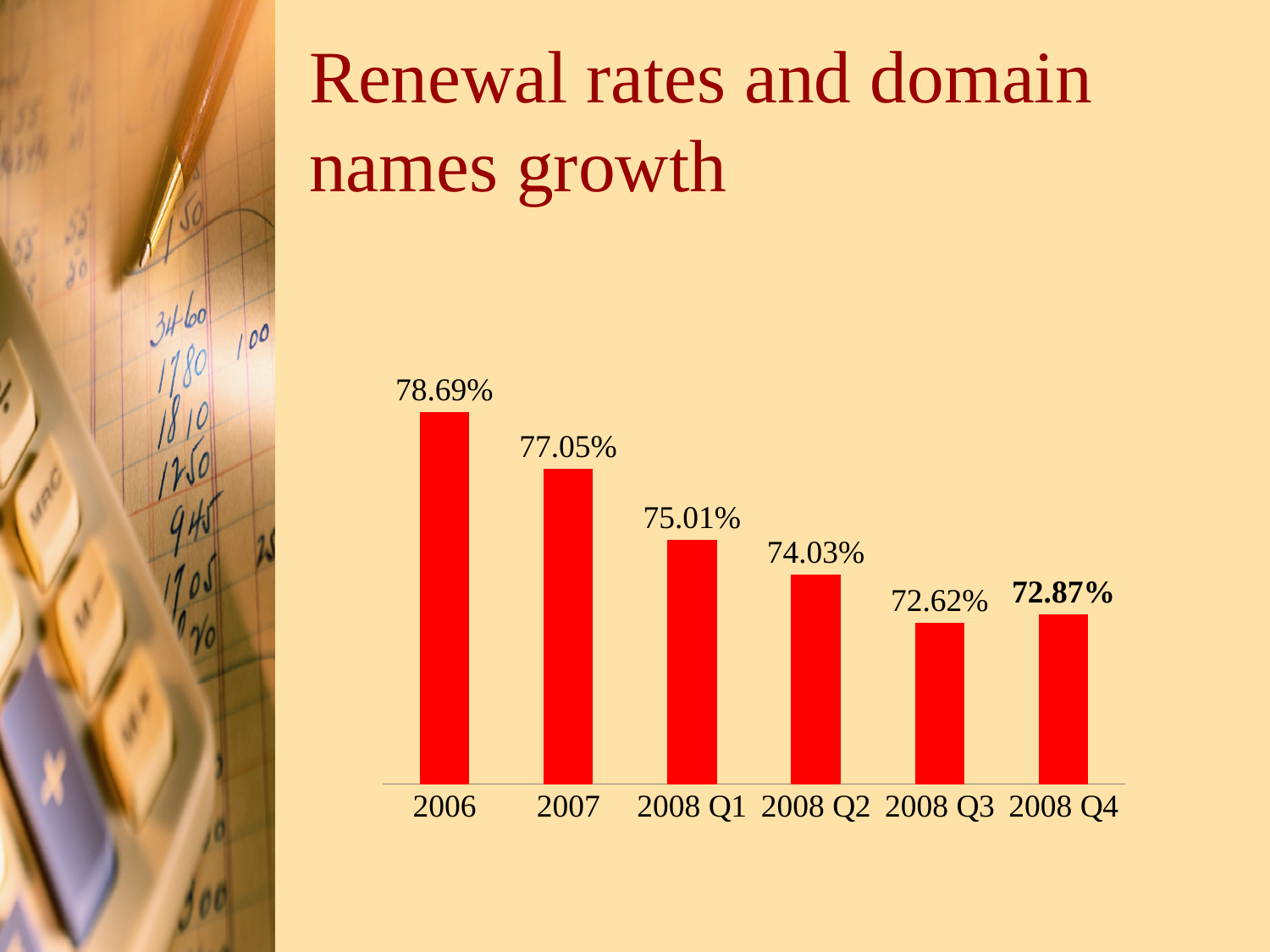
Which category has the lowest value? 2008 Q3 How many categories are shown on the x axis? 6 What kind of chart is shown on the slide? bar chart Do the values generally rise or fall from 2006 to 2008 Q3? fall Which category has the highest value? 2006 What is the difference between the values for 2006 and 2007? 1.64% What colour are the bars in the chart? red What is the value for 2008 Q4? 72.87% What is the value for 2006? 78.69% Which is larger, the value for 2007 or the value for 2008 Q1? 2007 What is the value for 2008 Q2? 74.03% What is the difference between the values for 2008 Q1 and 2008 Q2? 0.98%